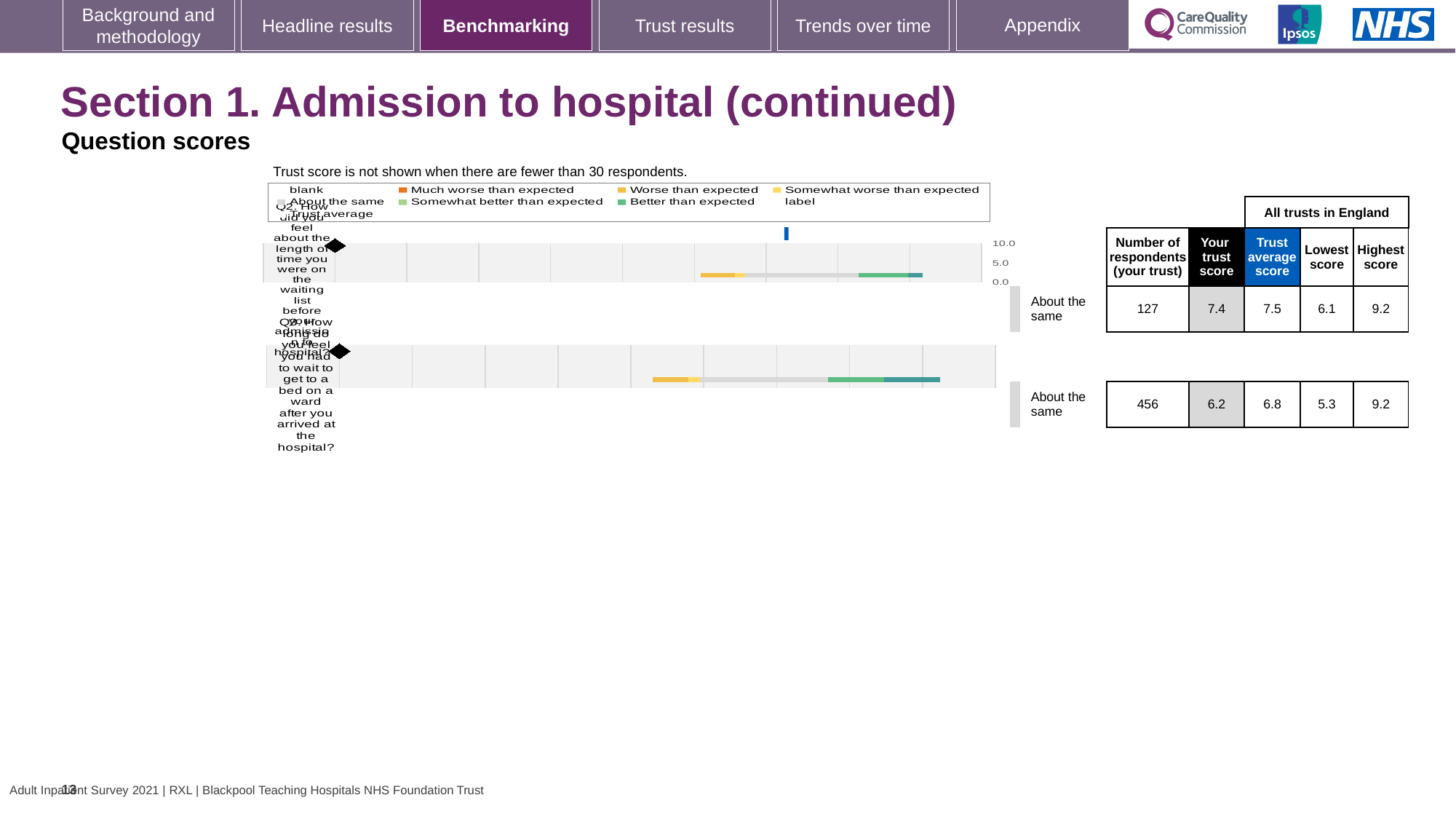
Is this trust's score for Q3 greater or less than 5.0 on the chart axis? greater Which question has the higher 'Your trust score', Q2 or Q3? Q2 What is the highest score among all trusts in England for Q3? 9.2 What benchmark category is shown for Q2? About the same By how much does the trust average score for Q3 exceed this trust's score for Q3? 0.6 How many questions are plotted on this slide? 2 How many respondents from the trust answered Q2? 127 How many respondents from the trust answered Q3? 456 What is the lowest score among all trusts in England for Q2? 6.1 What is the 'Your trust score' value for Q3 (how long did you feel you had to wait to get to a bed on a ward)? 6.2 What is the trust average score across all trusts in England for Q3? 6.8 What is the 'Your trust score' value for Q2 (how did you feel about the length of time on the waiting list before admission)? 7.4